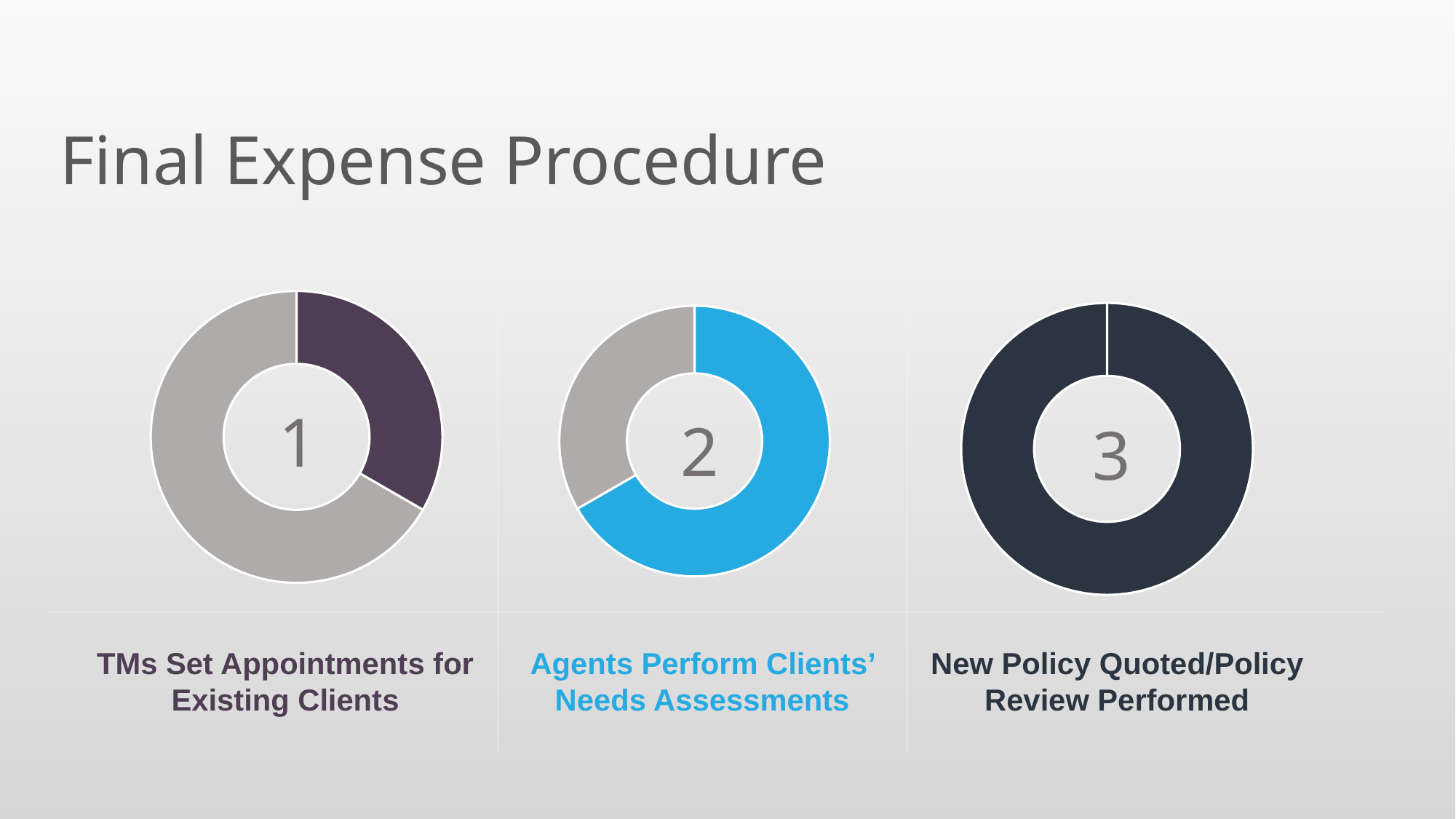
What is the caption under the middle chart labelled 2? Agents Perform Clients' Needs Assessments In the left chart labelled 1, which slice is larger, the grey slice or the purple slice? grey What kind of chart is the left chart labelled 1? doughnut chart In the middle chart labelled 2, which slice is larger, the blue slice or the grey slice? blue What number is shown in the centre of the right chart? 3 How many slices does the middle chart labelled 2 have? 2 How many doughnut charts are shown on the slide? 3 How many slices does the left chart labelled 1 have? 2